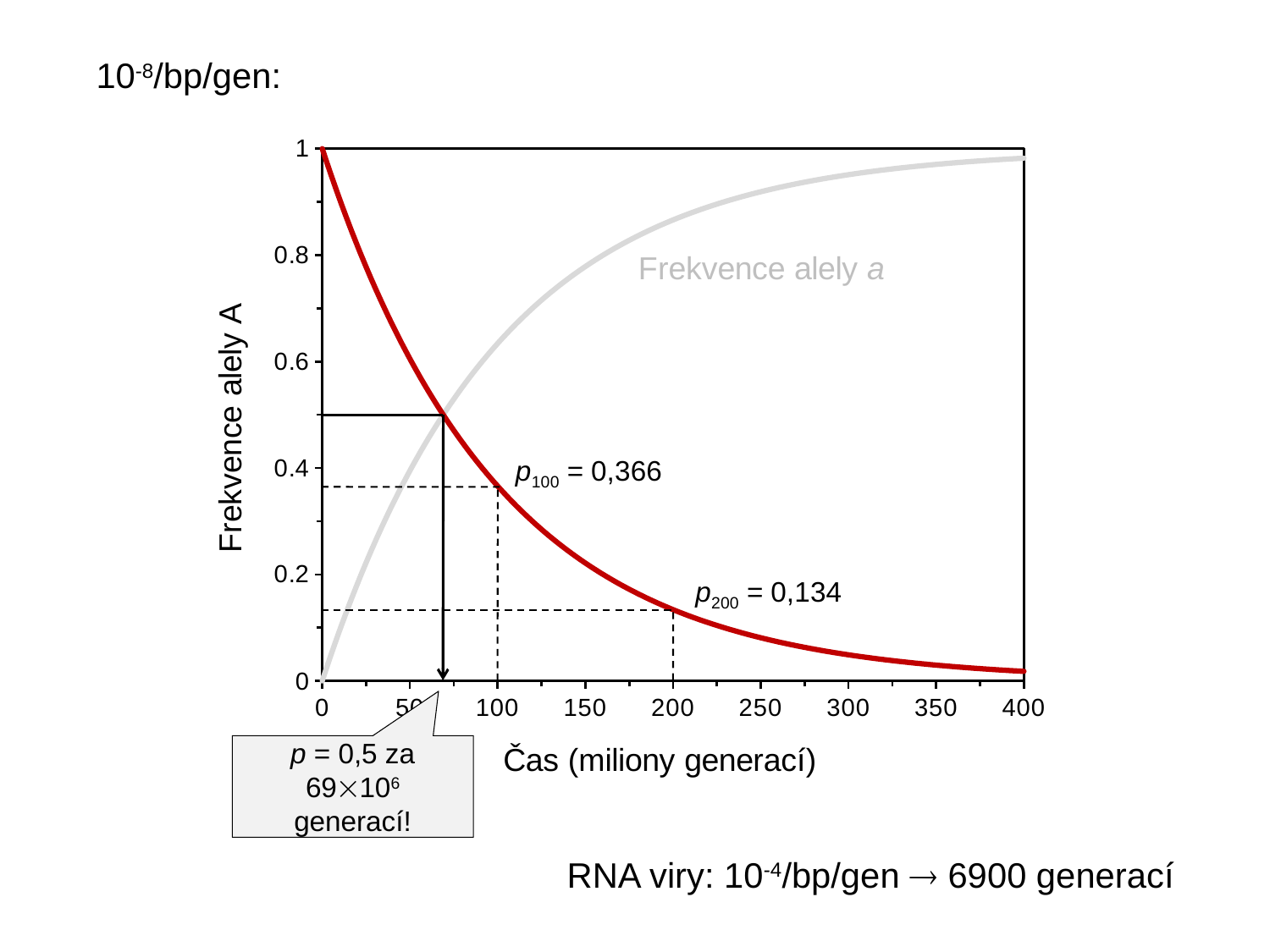
What kind of chart is shown on the slide? line chart What is the frequency of allele A at 100 million generations (p100)? 0,366 Is the frequency of allele a at 200 million generations greater or less than 0.8? greater What is the frequency of allele A at 200 million generations (p200)? 0,134 Is the frequency of allele A at 300 million generations greater or less than 0.2? less Does the frequency of allele a (grey curve) rise or fall as time increases? rise How many curves are plotted on the chart? 2 What is the label of the x axis? Čas (miliony generací) Does the frequency of allele A (red curve) rise or fall as time increases? fall After how many generations does the frequency of allele A reach p = 0,5, according to the callout? 69×10^6 generací What is the difference between p100 and p200 for allele A? 0,232 Which is larger, the frequency of allele A at 100 million generations or at 200 million generations? at 100 million generations